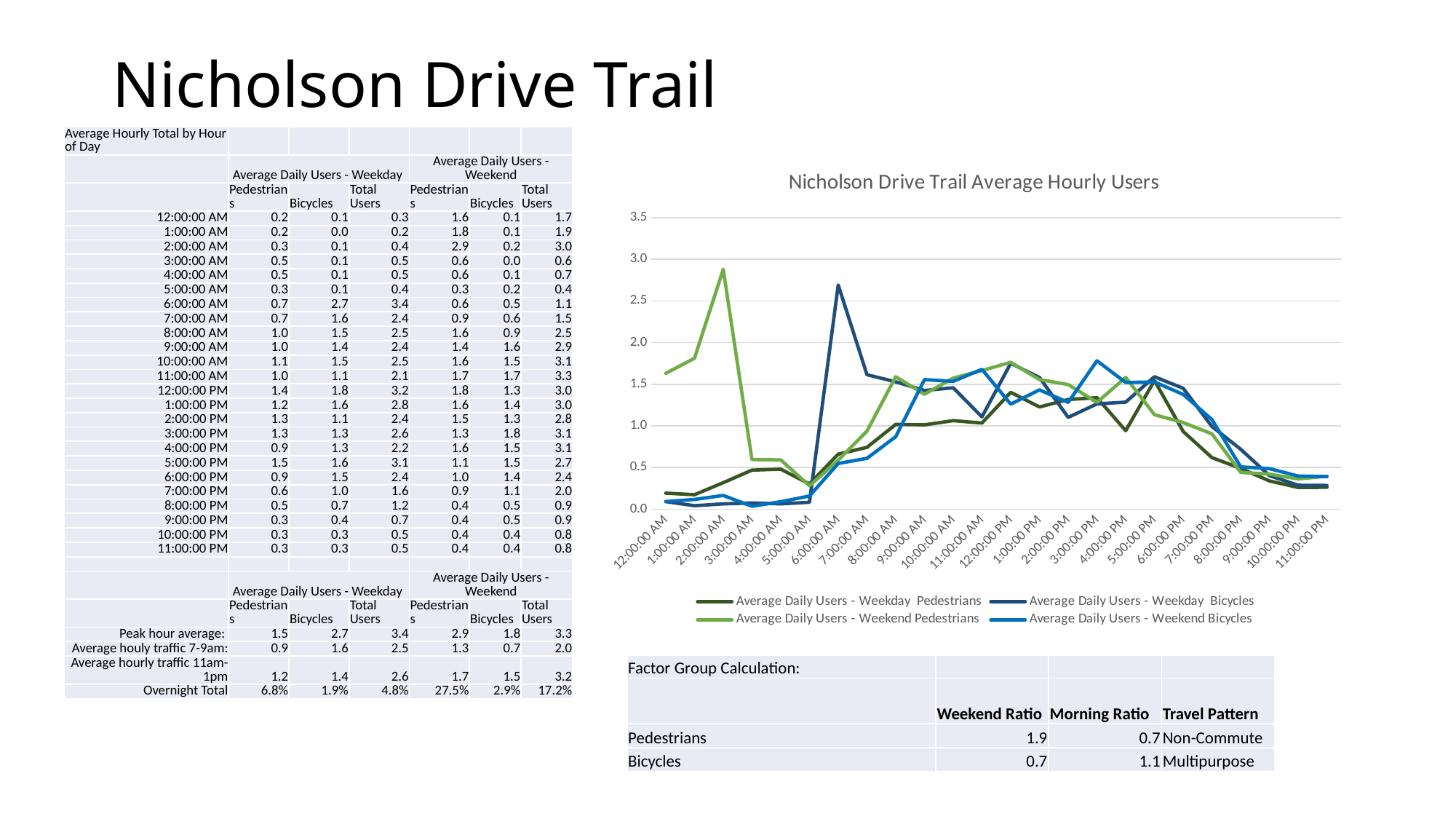
At which hour does the Average Daily Users - Weekend Pedestrians line reach its highest value? 2:00:00 AM Do the Weekday Pedestrians values rise or fall from 6:00:00 PM to 11:00:00 PM? fall At which hour does the Average Daily Users - Weekday Bicycles line reach its highest value? 6:00:00 AM What is the title of the chart? Nicholson Drive Trail Average Hourly Users What kind of chart is shown on the slide? line chart At 2:00:00 AM, which is larger: Weekend Pedestrians or Weekday Bicycles? Weekend Pedestrians How many hourly points are plotted along the x axis of the chart? 24 Is the value for Weekday Bicycles at 6:00:00 AM greater or less than 2.5? greater Is the value for Weekend Pedestrians at 2:00:00 AM greater or less than 3.0? less What is the value of Average Daily Users - Weekend Pedestrians at 2:00:00 AM? 2.9 How many series does the chart legend list? 4 What is the value of Average Daily Users - Weekday Bicycles at 6:00:00 AM? 2.7